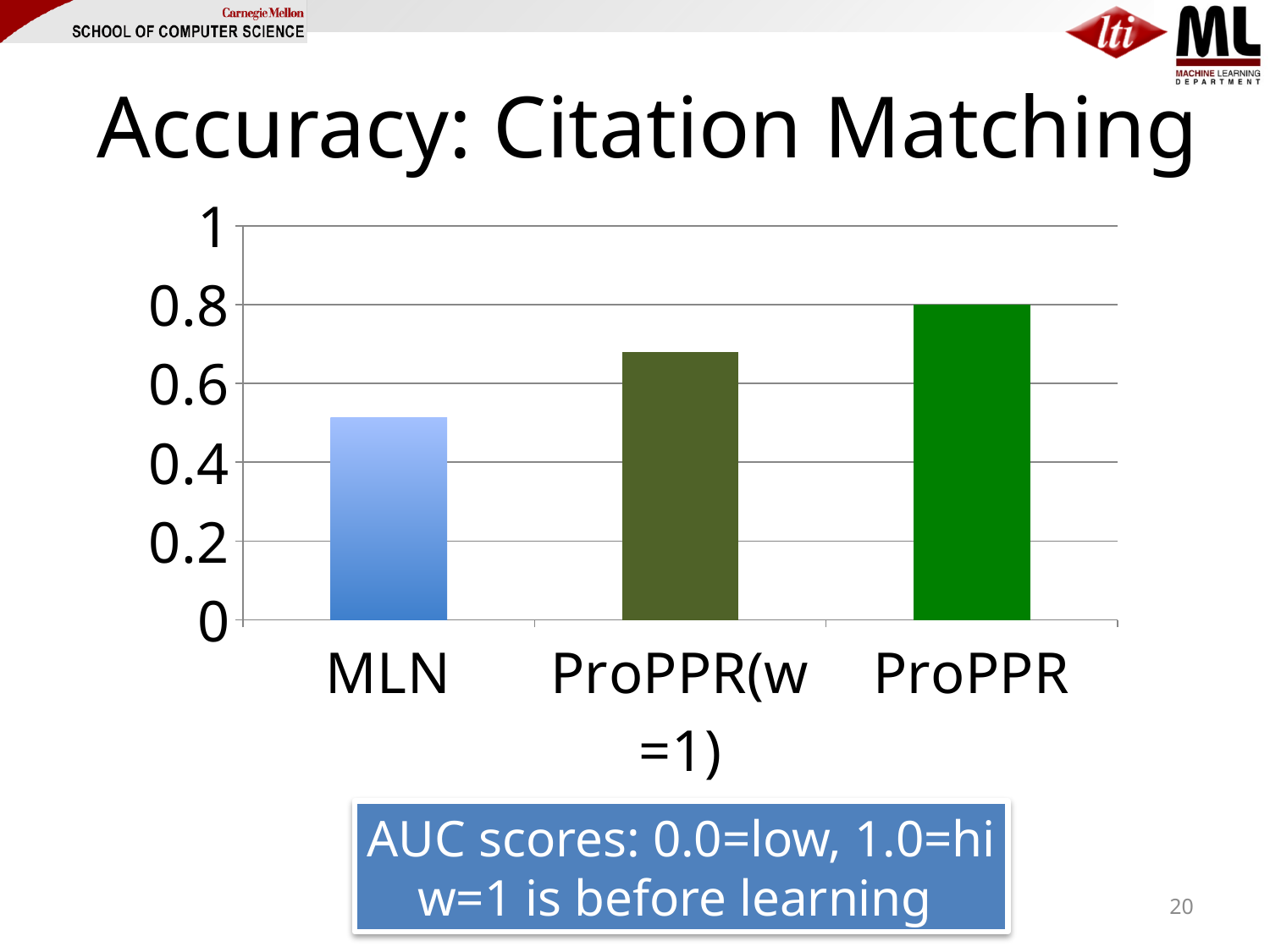
Is the value for ProPPR(w=1) greater or less than 0.8? less Which category has the lowest value? MLN What kind of chart is shown on the slide? bar chart Which category has the highest value? ProPPR How many categories (bars) are shown in the chart? 3 What is the title of the chart? Accuracy: Citation Matching What is the value for ProPPR? 0.8 Which is larger, the value for MLN or the value for ProPPR(w=1)? ProPPR(w=1) Is the value for ProPPR(w=1) greater or less than 0.6? greater Do the values rise or fall from left to right across the categories? rise Is the value for MLN greater or less than 0.4? greater